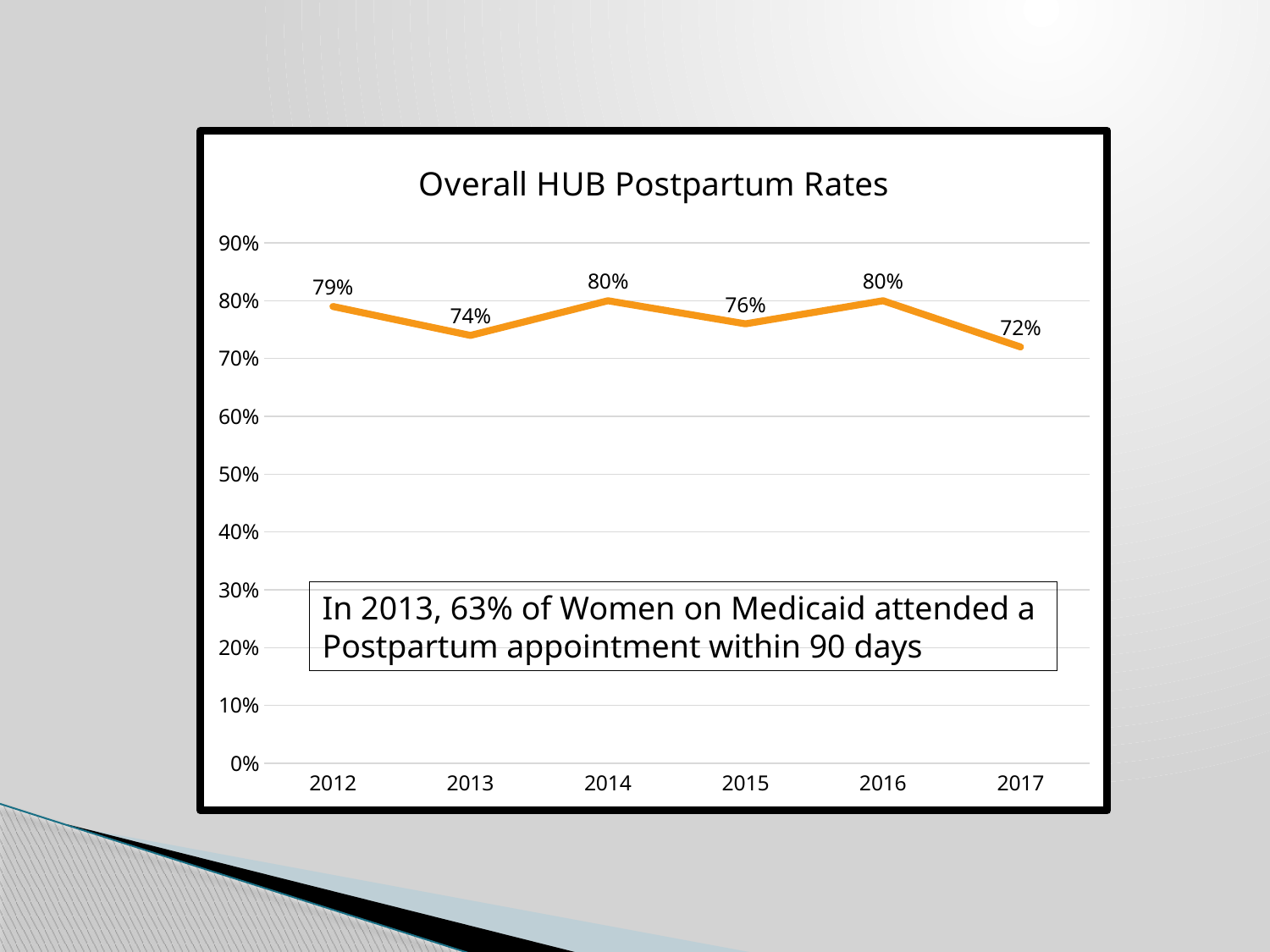
Which is larger, the rate for 2014 or the rate for 2015? 2014 Which year has the lowest postpartum rate? 2017 What is the postpartum rate for 2013? 74% What is the postpartum rate for 2017? 72% What is the postpartum rate for 2015? 76% How many years are plotted on the chart? 6 What is the postpartum rate for 2012? 79% Is the value for 2013 greater or less than 70%? greater What is the difference between the 2016 rate and the 2017 rate? 8% What kind of chart is shown? Line chart What is the difference between the 2012 rate and the 2013 rate? 5% What is the title of the chart? Overall HUB Postpartum Rates